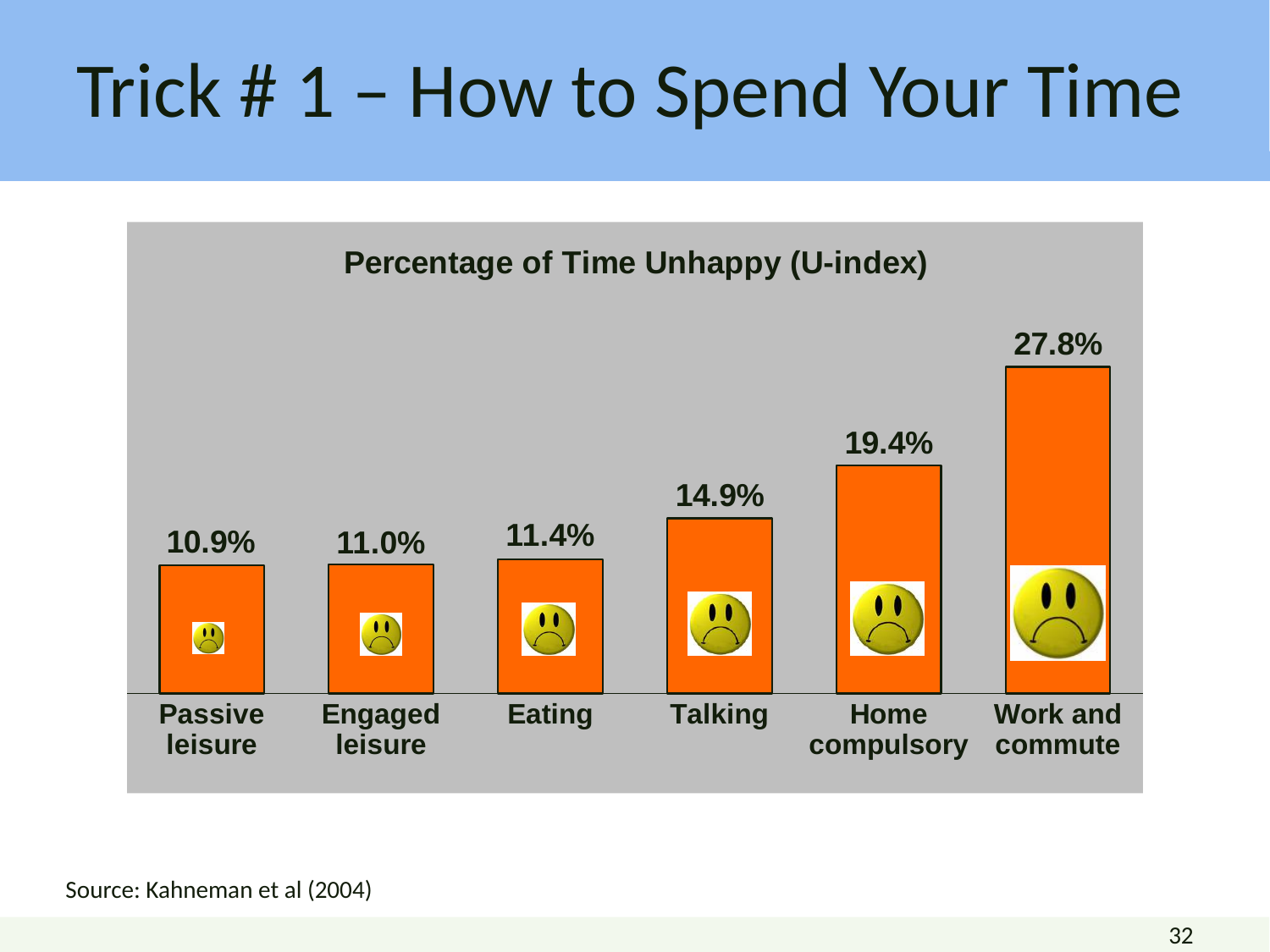
What is the difference in percentage of time unhappy between Work and commute and Home compulsory? 8.4% What is the value shown for Eating? 11.4% What is the difference between the values for Talking and Eating? 3.5% What is the percentage of time unhappy for Home compulsory? 19.4% What is the percentage of time unhappy for Talking? 14.9% What is the U-index value for Work and commute? 27.8% Which activity has the highest percentage of time unhappy? Work and commute Which has a higher percentage of time unhappy, Talking or Engaged leisure? Talking What is the title of the chart? Percentage of Time Unhappy (U-index) What type of chart is shown on the slide? Bar chart How many activity categories are shown in the chart? 6 Which activity has the lowest percentage of time unhappy? Passive leisure